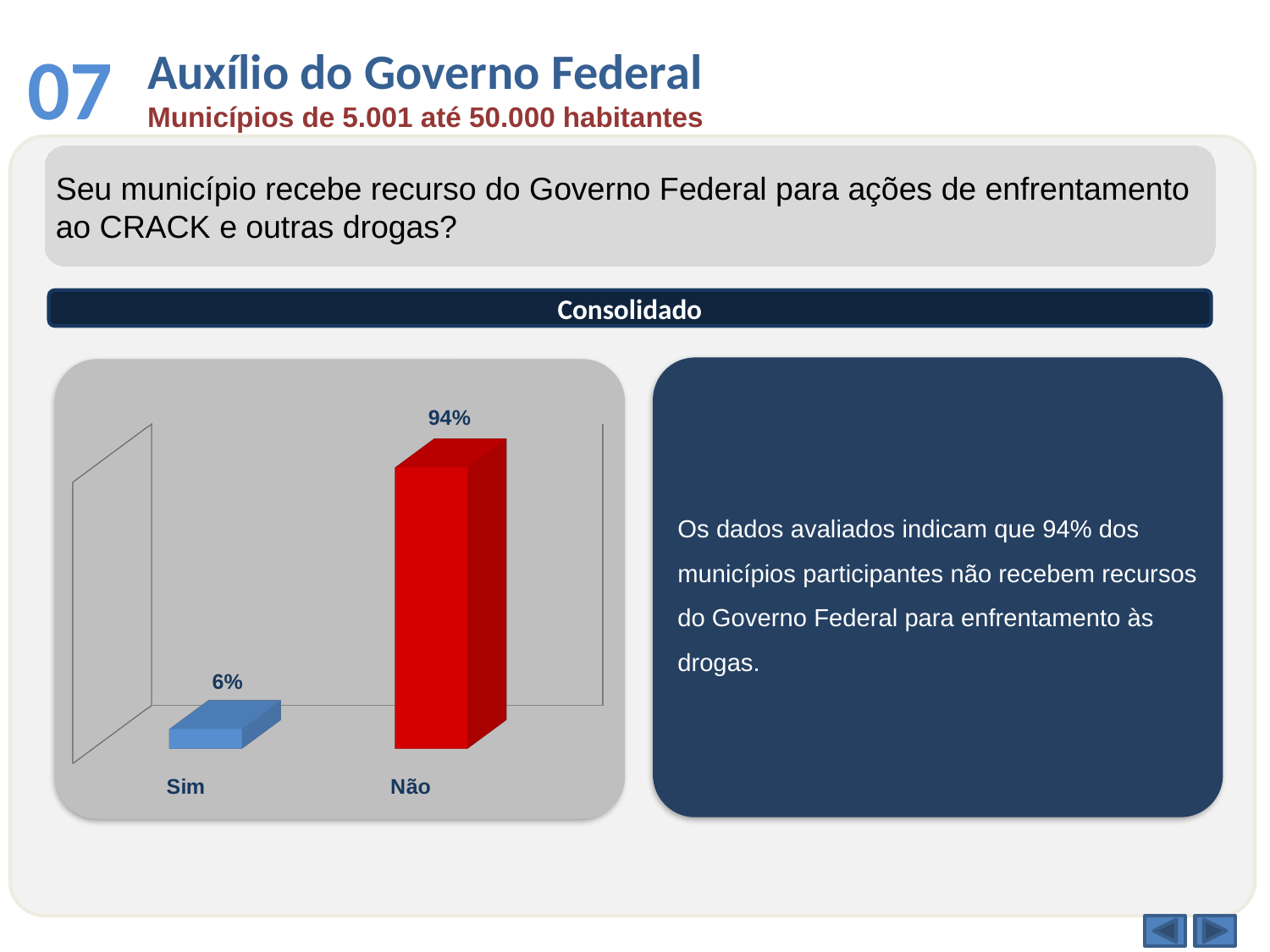
What colour is the bar for "Não"? Red What is the value for "Não"? 94% Which category has the lowest value? Sim What is the difference between the values for "Não" and "Sim"? 88% What colour is the bar for "Sim"? Blue What is the value for "Sim"? 6% What kind of chart is shown on the slide? Bar chart What is the total of the two values shown in the chart? 100% How many categories are shown in the chart? 2 Which category has the highest value? Não Which is larger, the value for "Sim" or the value for "Não"? Não